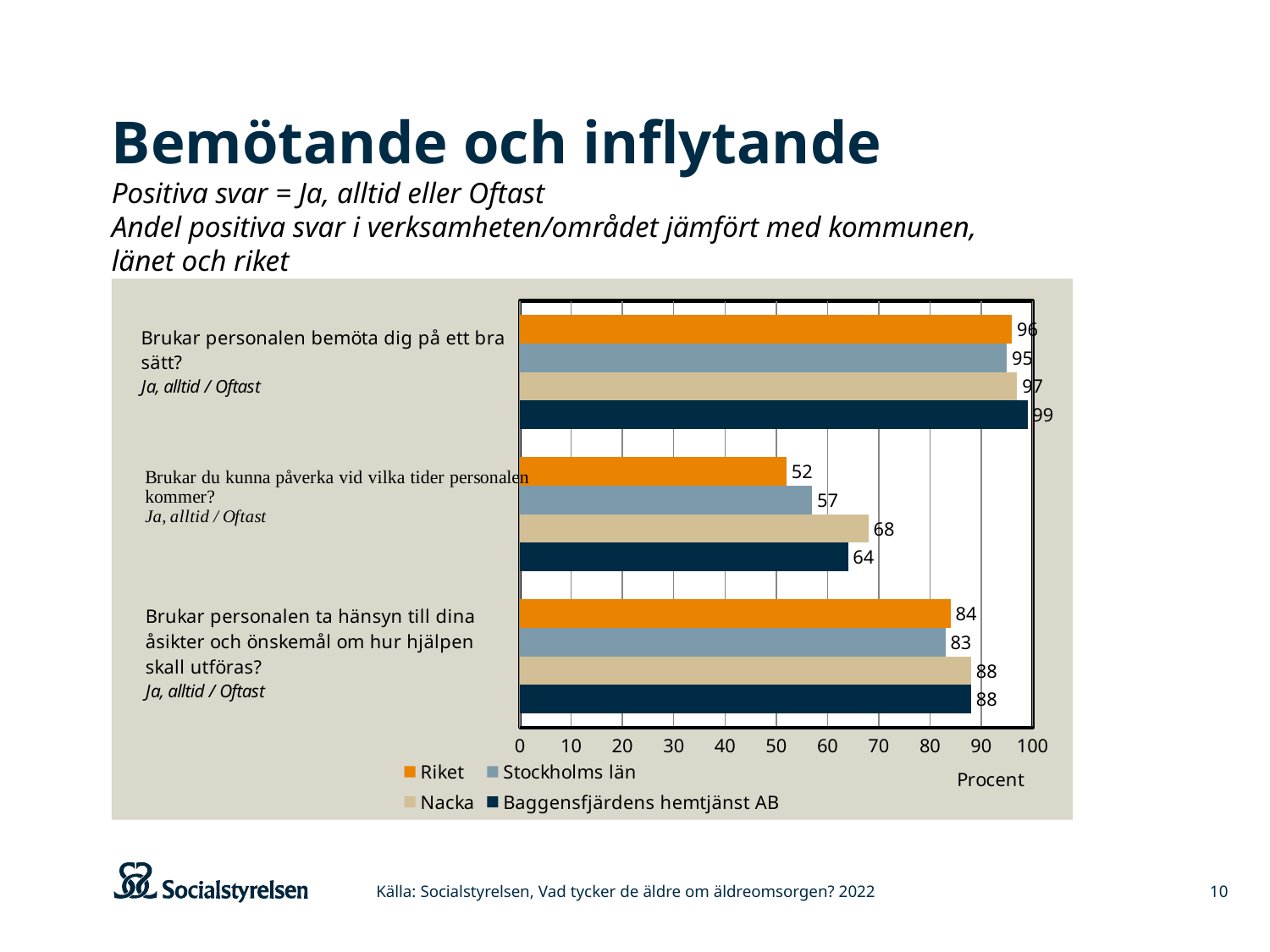
What is the value for Nacka for 'Brukar personalen ta hänsyn till dina åsikter och önskemål om hur hjälpen skall utföras?' 88 How many question categories are plotted on the chart? 3 What is the value for Baggensfjärdens hemtjänst AB for 'Brukar personalen bemöta dig på ett bra sätt?' 99 Which series has the lowest value for 'Brukar du kunna påverka vid vilka tider personalen kommer?' Riket What is the difference between Baggensfjärdens hemtjänst AB and Stockholms län for 'Brukar personalen bemöta dig på ett bra sätt?' 4 How many series does the legend list? 4 Which series has the highest value for 'Brukar du kunna påverka vid vilka tider personalen kommer?' Nacka For 'Brukar personalen ta hänsyn till dina åsikter och önskemål om hur hjälpen skall utföras?', which is larger: Riket or Stockholms län? Riket What is the value for Riket for 'Brukar du kunna påverka vid vilka tider personalen kommer?' 52 What label is shown on the horizontal axis of the chart? Procent What is the difference between Nacka and Riket for 'Brukar du kunna påverka vid vilka tider personalen kommer?' 16 What kind of chart is shown on the slide? Bar chart